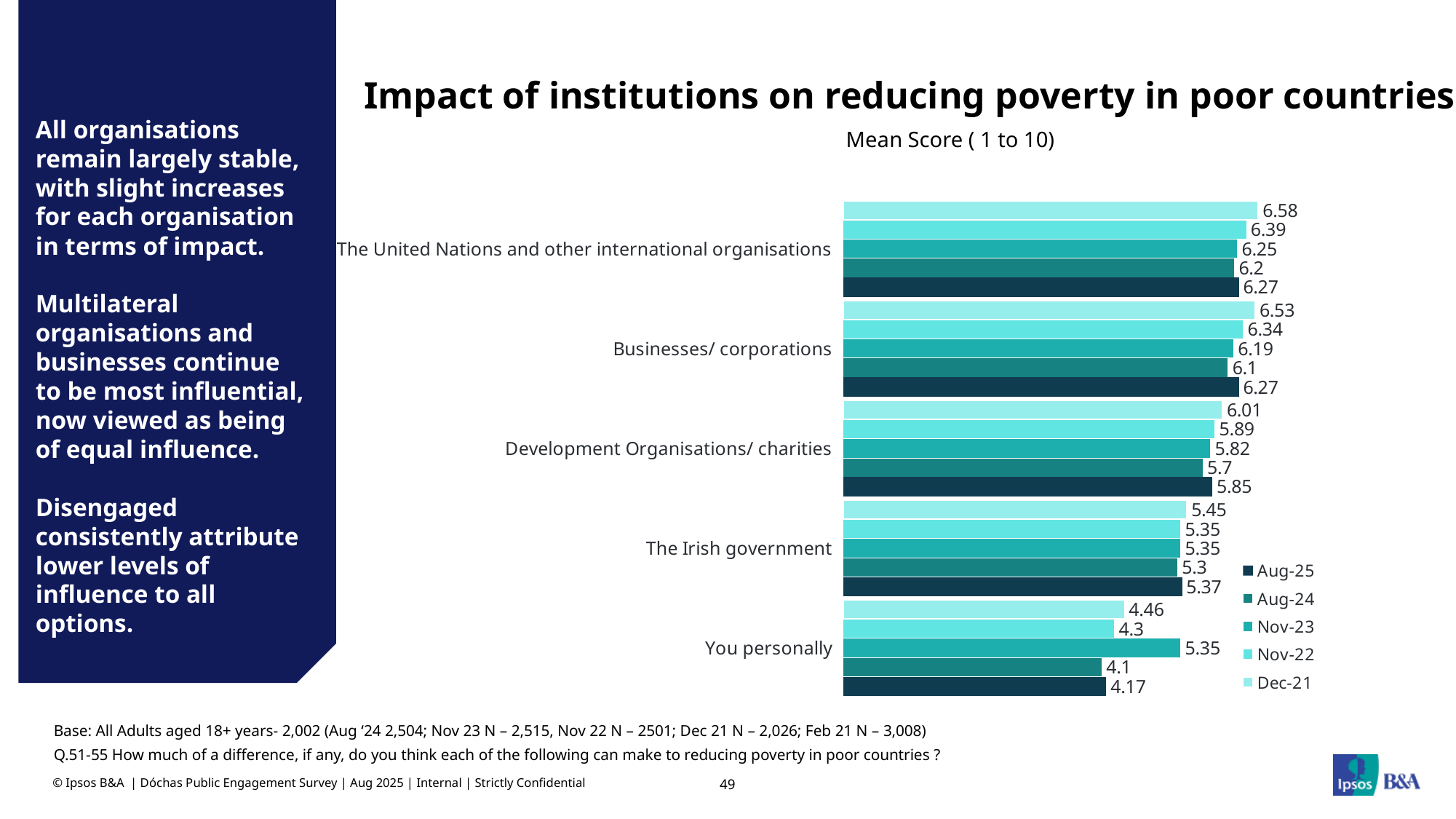
What is the difference between the Dec-21 and Aug-25 mean scores for The Irish government? 0.08 What is the Aug-24 mean score for Development Organisations/ charities? 5.7 What is the Aug-25 mean score for You personally? 4.17 How many institution categories are plotted on the chart? 5 Which category has the lowest Aug-25 mean score? You personally What type of chart is shown on the slide? bar chart Which category has the highest Dec-21 mean score? The United Nations and other international organisations What is the Dec-21 mean score for Businesses/ corporations? 6.53 What is the subtitle shown under the chart title? Mean Score ( 1 to 10) Which is larger for Development Organisations/ charities: the Dec-21 score or the Aug-25 score? Dec-21 How many series does the legend list? 5 What is the Aug-25 mean score for The United Nations and other international organisations? 6.27